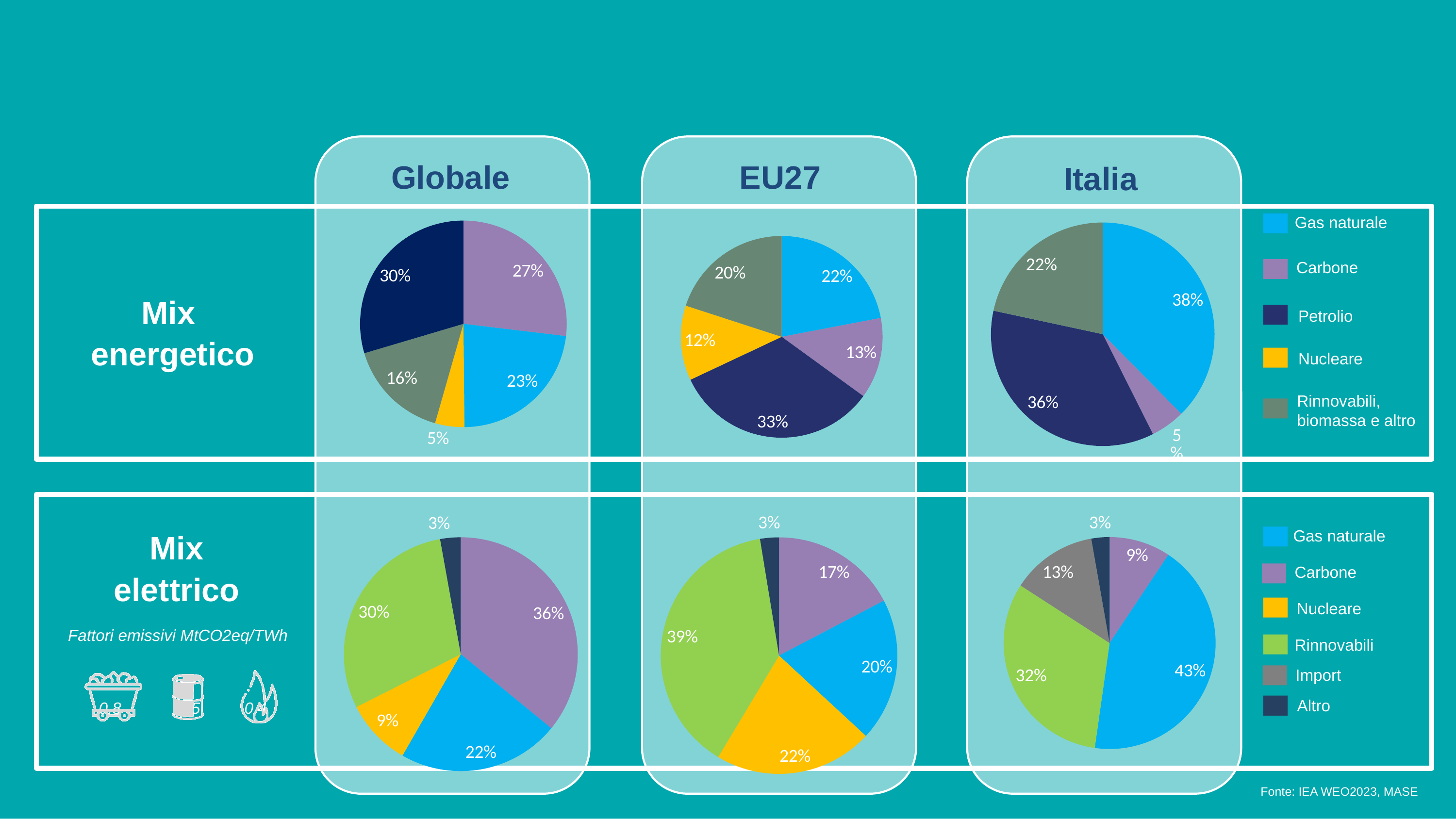
In the Mix elettrico Italia pie chart, what is the difference between the Gas naturale share and the Rinnovabili share? 11% In the Mix elettrico EU27 pie chart, which category has the largest share? Rinnovabili How many entries does the legend for the Mix elettrico row list? 6 In the Mix energetico EU27 pie chart, what share is Nucleare? 12% How many slices does the Mix elettrico Italia pie chart have? 5 In the Mix energetico Globale pie chart, what share is Petrolio? 30% What type of chart is used for the Mix energetico Globale data? Pie chart In the Mix energetico Italia pie chart, which category has the smallest share? Carbone In the Mix energetico EU27 pie chart, which is larger: Petrolio or Gas naturale? Petrolio In the Mix elettrico Italia pie chart, what share is Import? 13% In the Mix energetico Italia pie chart, which category has the largest share? Gas naturale In the Mix elettrico Globale pie chart, what share is Carbone? 36%